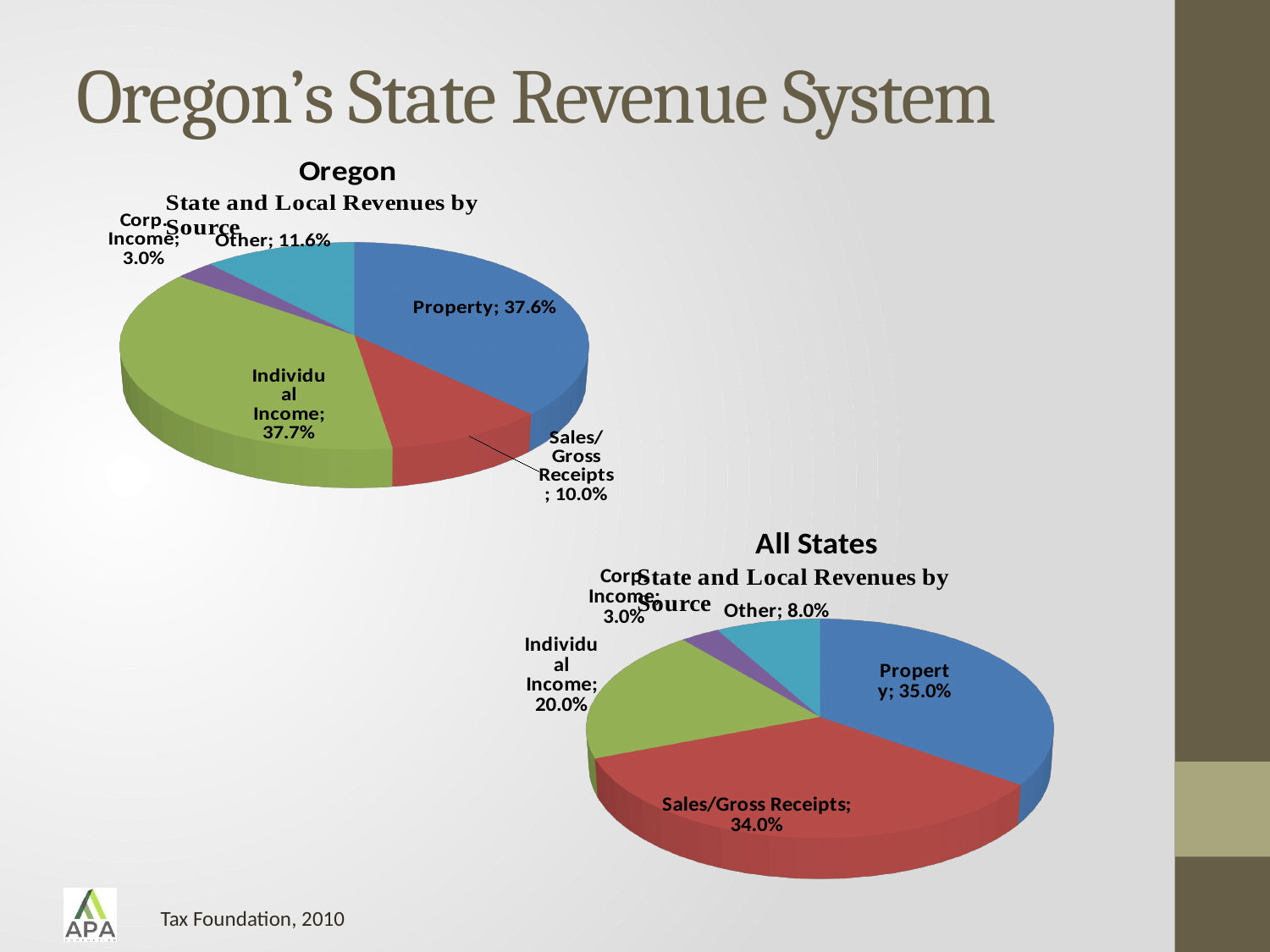
Which is larger: the Individual Income share in the Oregon chart or in the All States chart? Oregon In the All States chart, what is the share for Other? 8.0% In the All States chart, which source has the smallest share? Corp. Income In the All States chart, what share of revenues comes from Sales/Gross Receipts? 34.0% In the Oregon chart, which source has the smallest share? Corp. Income What source is cited at the bottom of the slide for the charts? Tax Foundation, 2010 In the Oregon chart, how many percentage points larger is the Property share than the Sales/Gross Receipts share? 27.6 percentage points In the Oregon chart, what share of state and local revenues comes from Property? 37.6% In the All States chart, what share of revenues comes from Individual Income? 20.0% How many sources are shown in the Oregon pie chart? 5 In the Oregon chart, what share of revenues comes from Sales/Gross Receipts? 10.0% What type of chart is used for the All States data? Pie chart